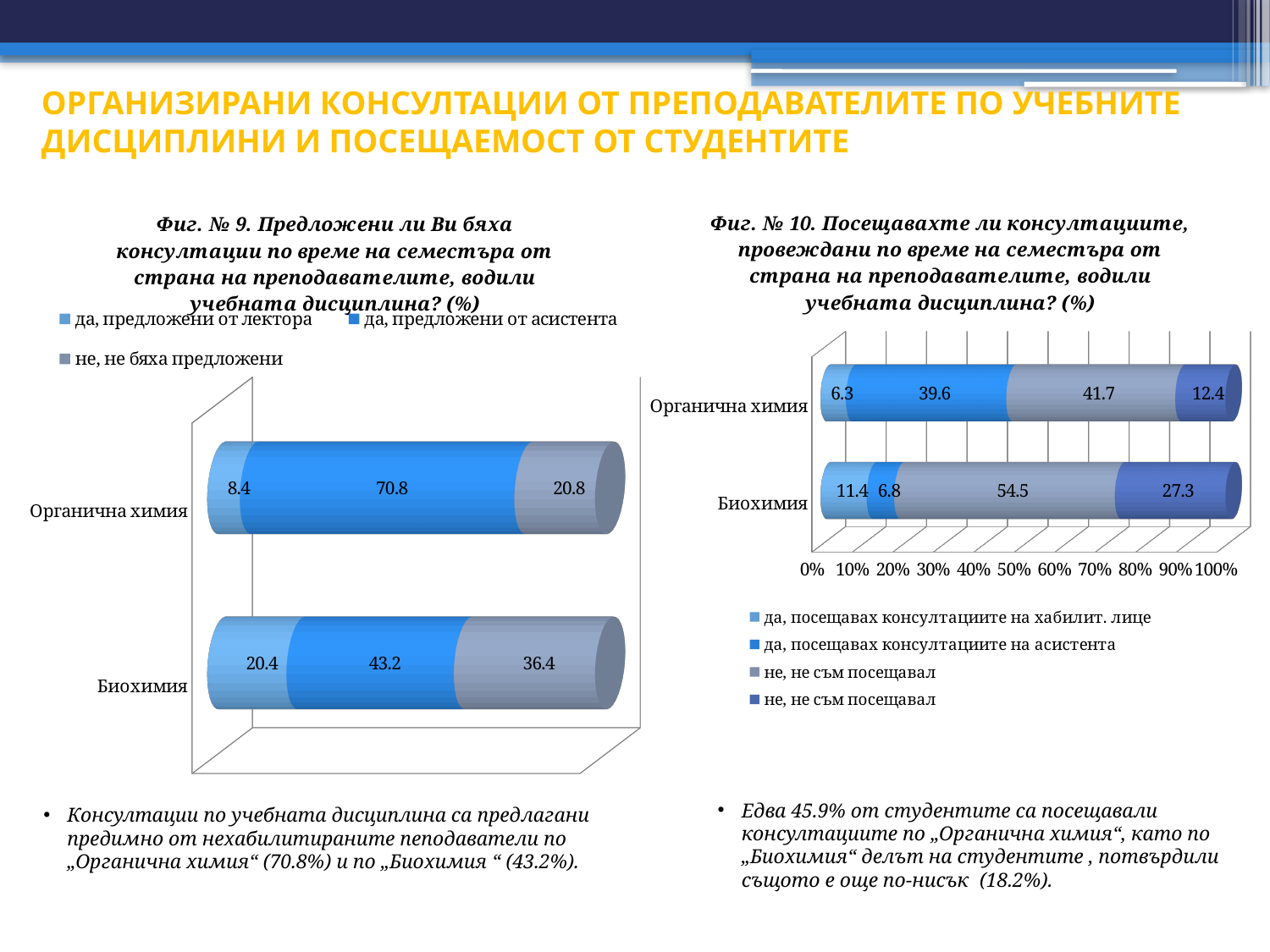
In the chart titled "Фиг. № 10" (right), which segment of the Биохимия bar is the largest? не, не съм посещавал (54.5) In the chart titled "Фиг. № 10" (right), how many categories are shown on the vertical axis? 2 What type of chart is the chart titled "Фиг. № 9" (left)? Stacked bar chart In the chart titled "Фиг. № 10" (right), what is the value for "да, посещавах консултациите на асистента" for Органична химия? 39.6 In the chart titled "Фиг. № 10" (right), what is the value for "да, посещавах консултациите на хабилит. лице" for Биохимия? 11.4 In the chart titled "Фиг. № 10" (right), how many series does the legend list? 4 In the chart titled "Фиг. № 9" (left), what is the difference between the "да, предложени от асистента" values for Органична химия and Биохимия? 27.6 In the chart titled "Фиг. № 9" (left), how many series does the legend list? 3 In the chart titled "Фиг. № 9" (left), what is the value for "да, предложени от лектора" for Биохимия? 20.4 In the chart titled "Фиг. № 9" (left), what is the value for "да, предложени от асистента" for Органична химия? 70.8 In the chart titled "Фиг. № 10" (right), which is larger: the "да, посещавах консултациите на асистента" value for Органична химия or for Биохимия? Органична химия In the chart titled "Фиг. № 9" (left), what is the value for "не, не бяха предложени" for Биохимия? 36.4